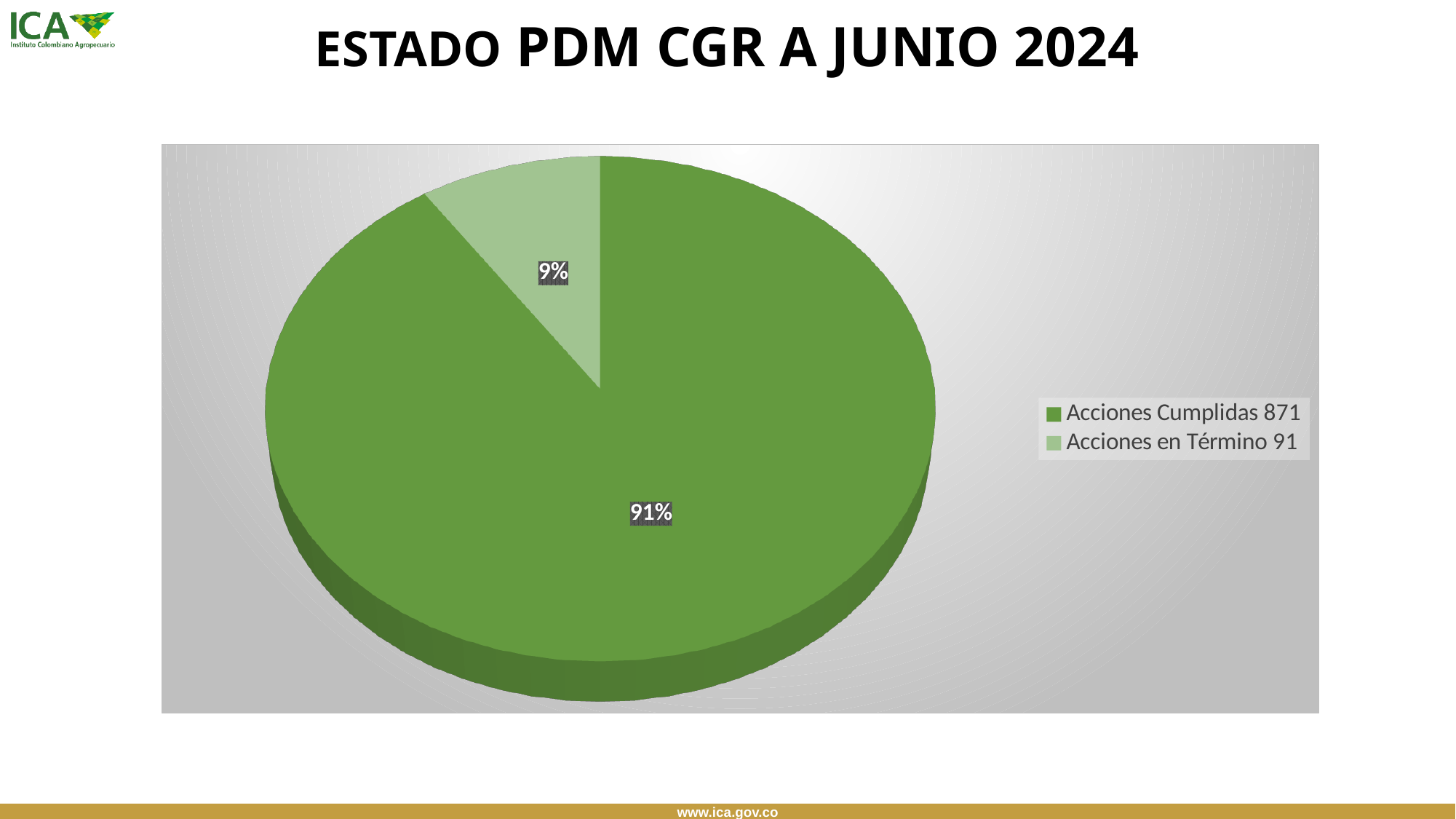
Which slice is the smallest in the pie chart? Acciones en Término 91 What number appears in the legend entry for 'Acciones Cumplidas'? 871 How many slices does the pie chart have? 2 What is the title of the slide containing the pie chart? ESTADO PDM CGR A JUNIO 2024 Which legend entry is shown in the lighter green colour? Acciones en Término 91 How many entries does the legend list? 2 What is the difference in percentage points between the 'Acciones Cumplidas 871' slice and the 'Acciones en Término 91' slice? 82 percentage points What percentage share does the 'Acciones en Término 91' slice have? 9% Which slice is the largest in the pie chart? Acciones Cumplidas 871 What kind of chart is shown on the slide? Pie chart What percentage share does the 'Acciones Cumplidas 871' slice have? 91% Which slice is larger: 'Acciones Cumplidas 871' or 'Acciones en Término 91'? Acciones Cumplidas 871